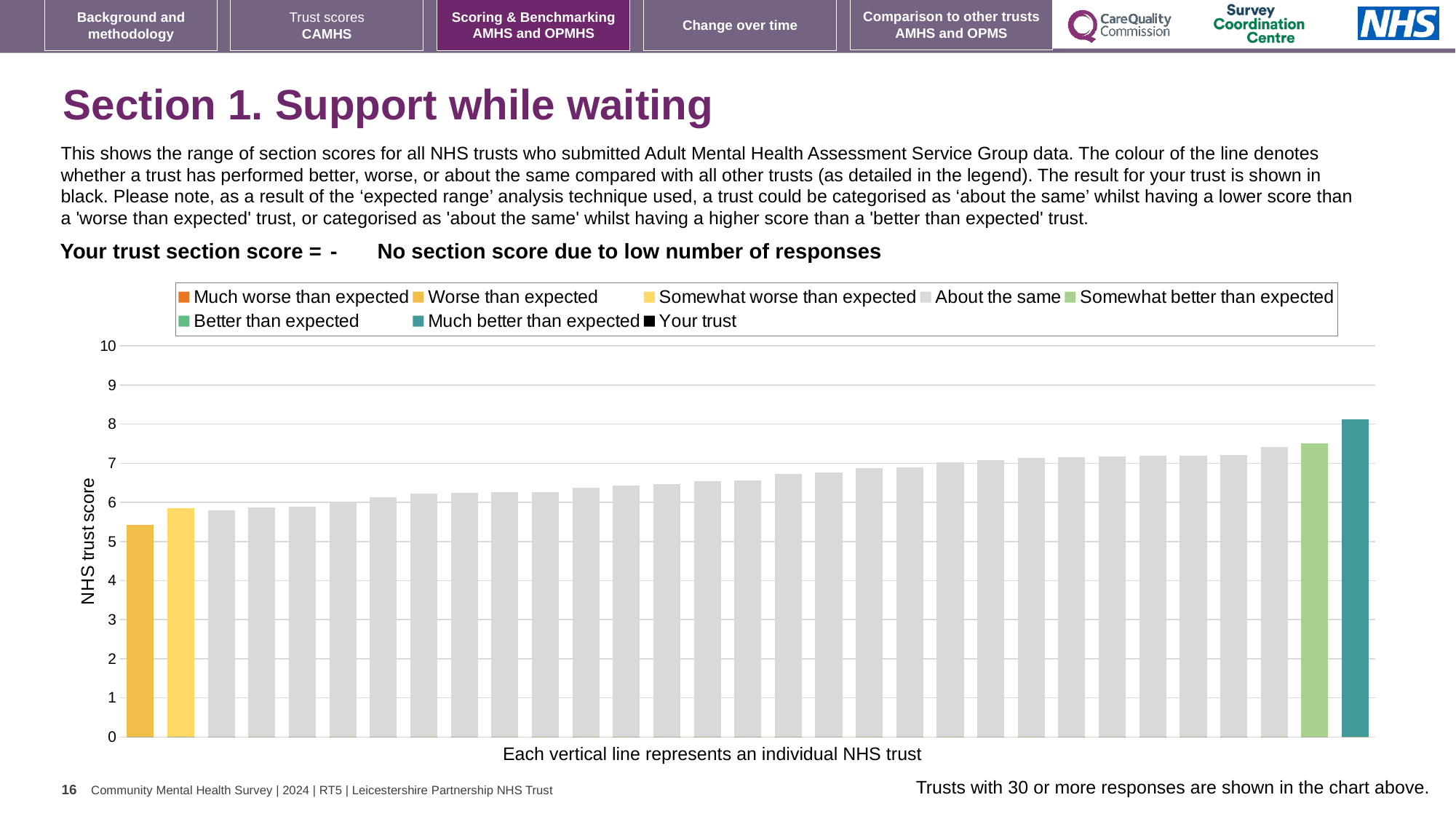
What is the highest value shown on the vertical axis? 10 What is the label on the vertical axis of the chart? NHS trust score Is the value of the leftmost bar greater or less than 5? greater Is the value of the rightmost bar greater or less than 7? greater How many entries does the chart legend list? 8 What kind of chart is shown on the slide? bar chart Which legend category does the colour of the tallest bar correspond to? Much better than expected Is the value of the second bar from the right greater or less than 7? greater Do the bar values rise or fall from left to right along the x axis? rise Which bar is the highest: the leftmost or the rightmost? rightmost